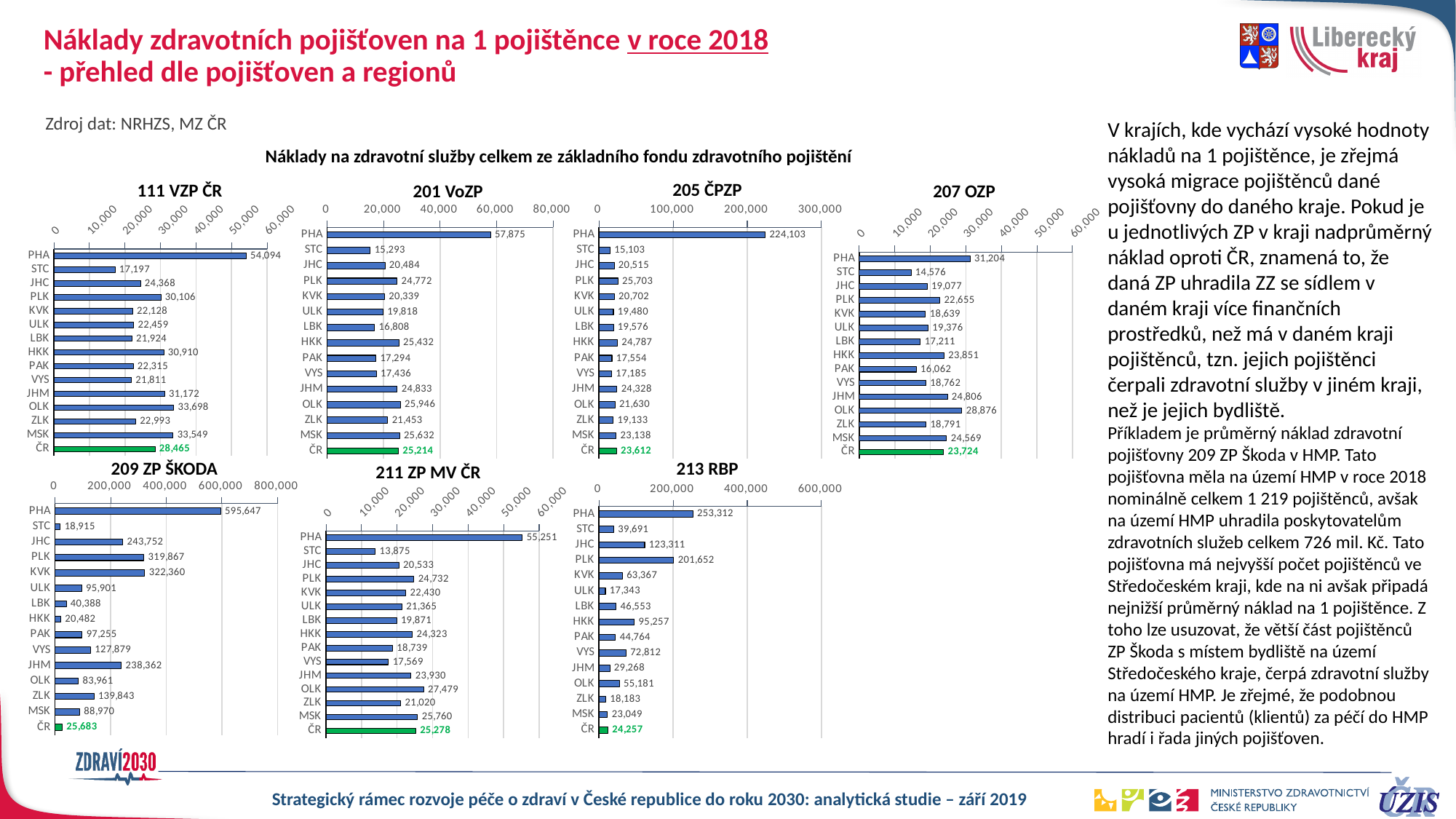
In the 207 OZP chart, what is the difference between the value for PHA and the value for ČR? 7,480 How many bar charts are shown on the slide? 7 In the 213 RBP chart, which is larger, the value for JHC or the value for PLK? PLK In the 211 ZP MV ČR chart, what is the value for LBK? 19,871 In the 209 ZP ŠKODA chart, which region has the highest value? PHA In the 111 VZP ČR chart, what is the difference between the value for ČR and the value for LBK? 6,541 How many categories are shown in the 201 VoZP chart? 15 In the 201 VoZP chart, what is the value for ČR? 25,214 In the 111 VZP ČR chart, what is the value for PHA? 54,094 What kind of chart is the 211 ZP MV ČR chart? Bar chart In the 205 ČPZP chart, which region has the lowest value? STC In the 205 ČPZP chart, is the value for PHA greater or less than 200,000? greater